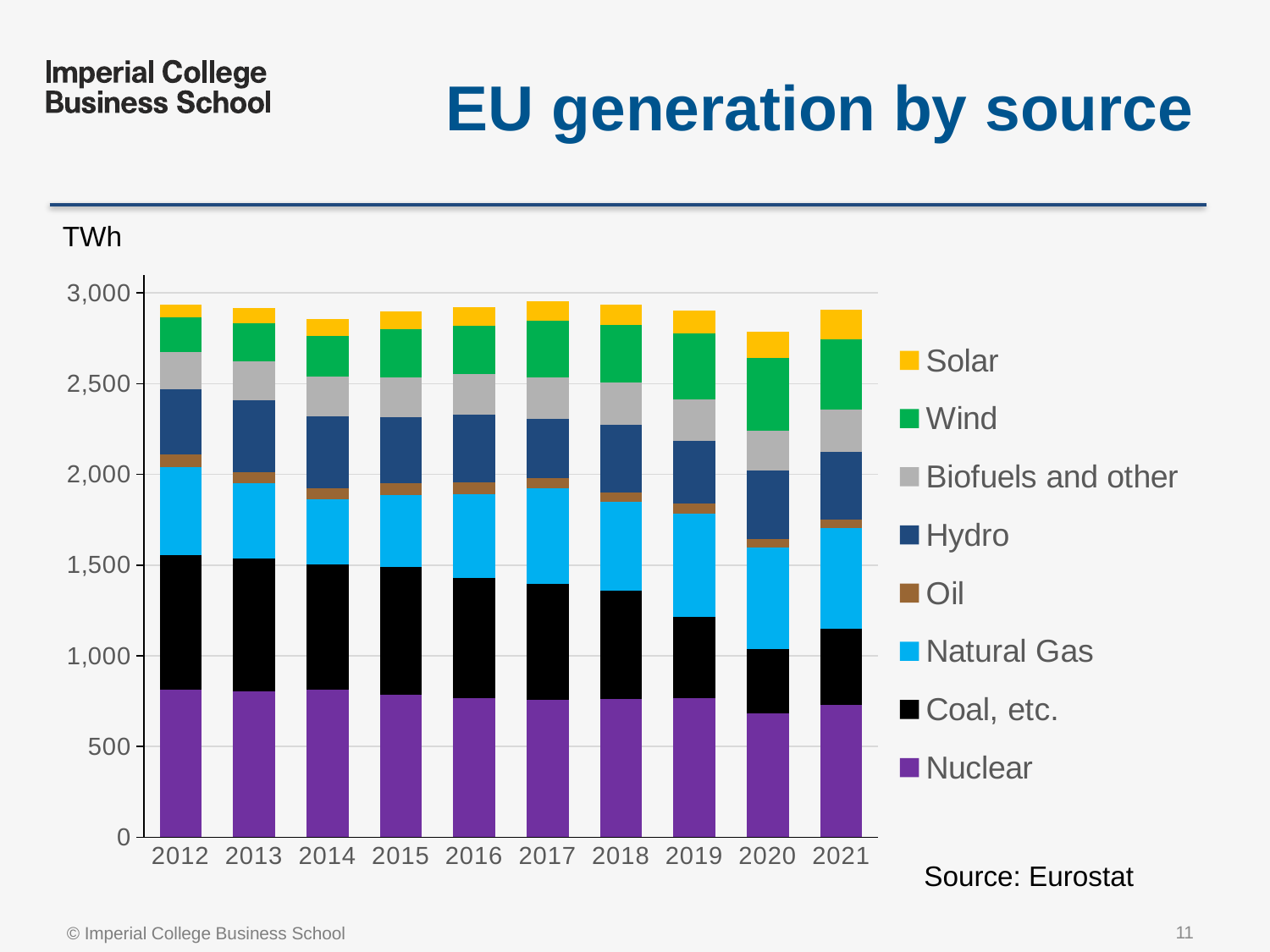
Which year has the larger Nuclear value, 2012 or 2020? 2012 What kind of chart is shown on the slide? Stacked bar chart How many years are shown on the x axis of the chart? 10 Is the Nuclear value in 2012 greater or less than 500? greater How many series does the chart's legend list? 8 Which year has the larger Wind value, 2012 or 2021? 2021 Is the total generation in 2020 greater or less than 2,500? greater What is the title of the chart? EU generation by source Does the Coal, etc. segment rise or fall from 2012 to 2021? fall What unit is the y axis of the chart measured in? TWh Does the Wind segment rise or fall from 2012 to 2021? rise Is the total generation in 2012 greater or less than 3,000? less